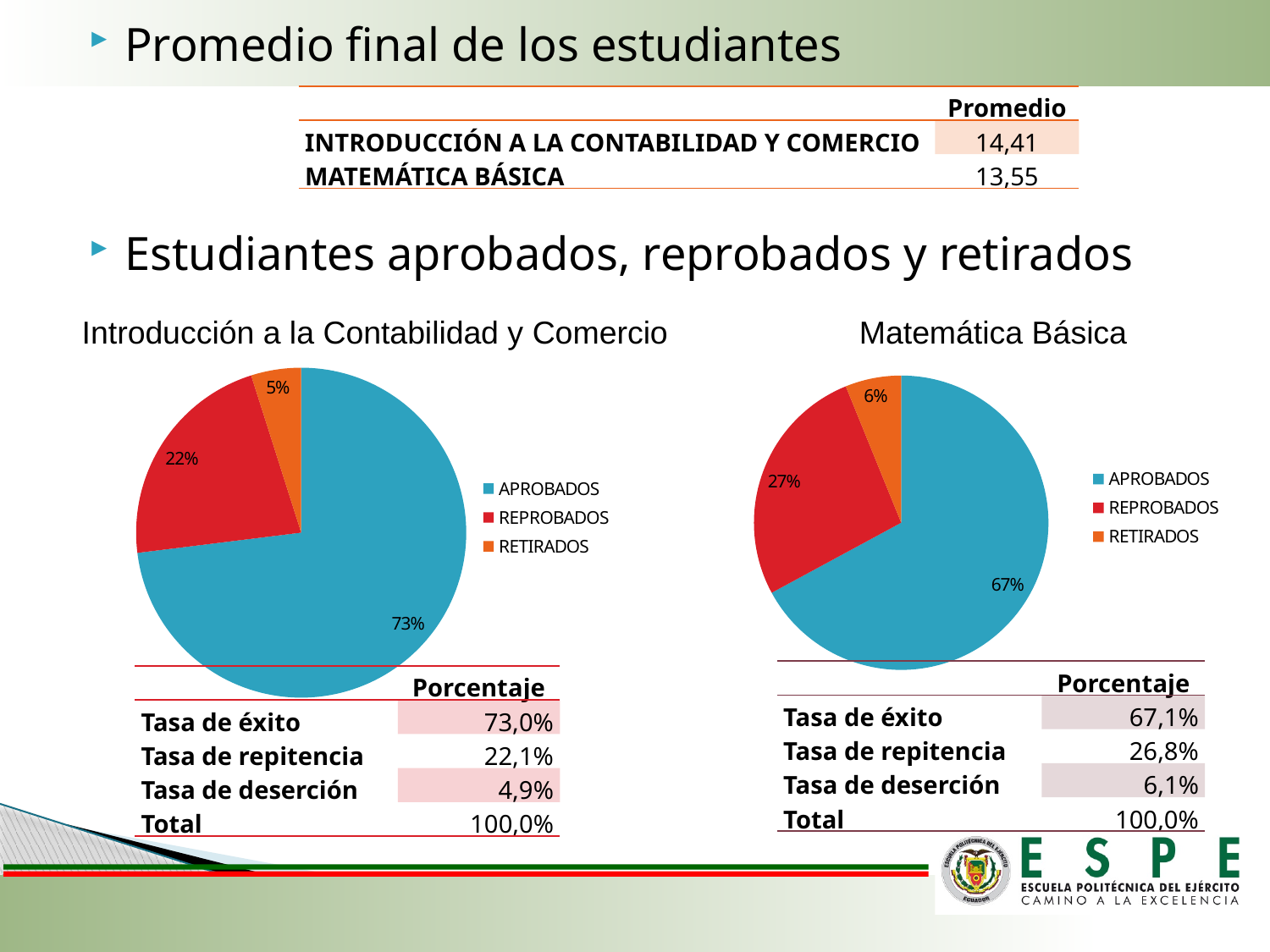
Which chart shows a larger APROBADOS share, 'Introducción a la Contabilidad y Comercio' or 'Matemática Básica'? Introducción a la Contabilidad y Comercio In the 'Introducción a la Contabilidad y Comercio' pie chart, what colour is the REPROBADOS slice? Red In the 'Matemática Básica' pie chart, what share of the pie is RETIRADOS? 6% In the 'Matemática Básica' pie chart, which category has the smallest slice? RETIRADOS In the 'Matemática Básica' pie chart, what percentage is shown for REPROBADOS? 27% In the 'Introducción a la Contabilidad y Comercio' pie chart, what percentage is shown for APROBADOS? 73% In the 'Matemática Básica' pie chart, what percentage is shown for RETIRADOS? 6% In the 'Introducción a la Contabilidad y Comercio' pie chart, which category has the largest slice? APROBADOS How many slices does the 'Matemática Básica' pie chart have? 3 How many entries does the legend of the 'Introducción a la Contabilidad y Comercio' chart list? 3 What type of chart is used for 'Matemática Básica'? Pie chart In the 'Introducción a la Contabilidad y Comercio' pie chart, what is the difference between the REPROBADOS and RETIRADOS percentages? 17%